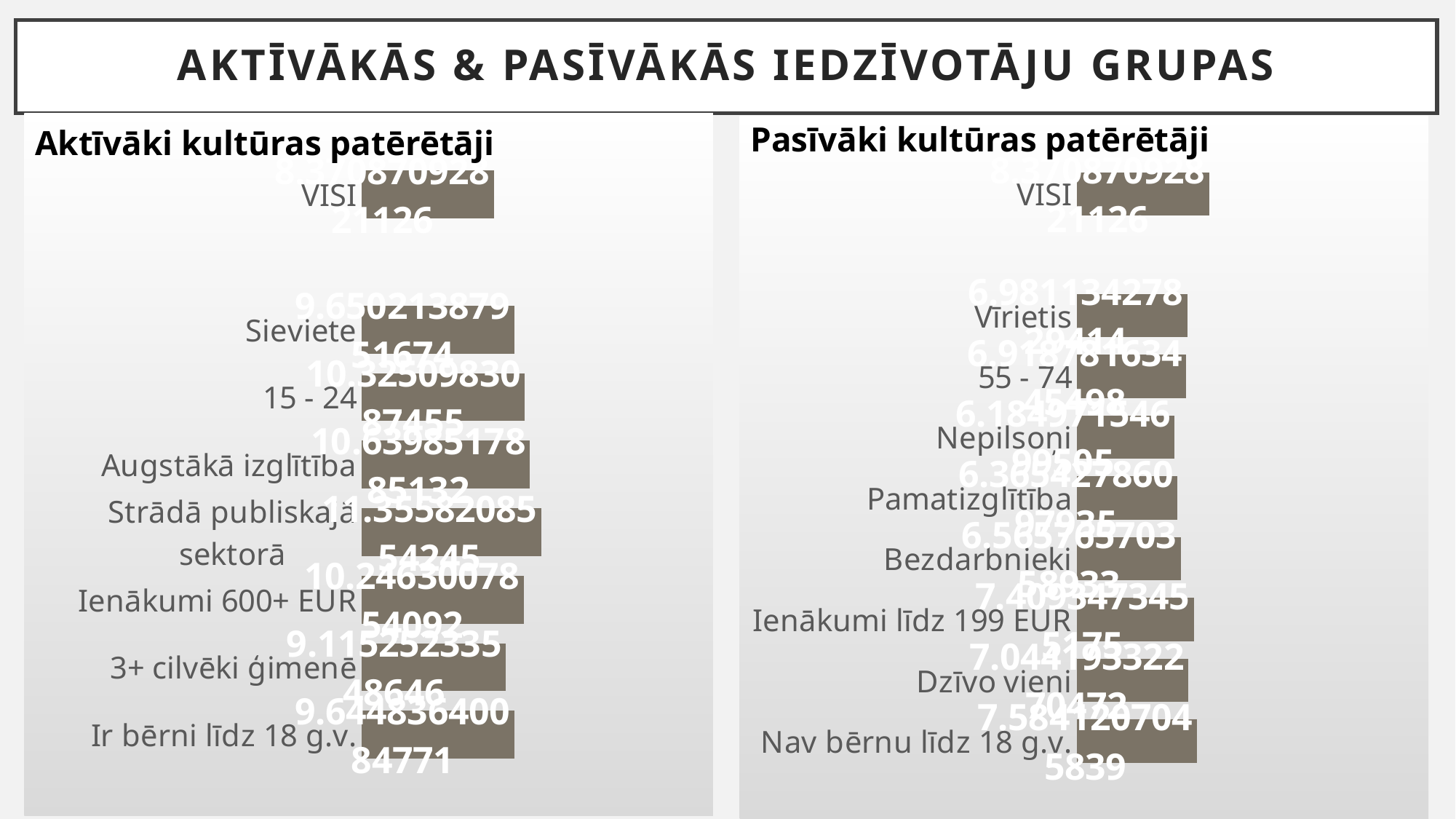
How many categories are shown in the "Aktīvāki kultūras patērētāji" chart on the left? 8 In the "Aktīvāki kultūras patērētāji" chart on the left, which category has the longest bar? Strādā publiskajā sektorā What kind of chart is the "Pasīvāki kultūras patērētāji" chart on the right? bar chart In the "Pasīvāki kultūras patērētāji" chart on the right, which has the larger value: VISI or Nepilsoņi? VISI What is the title of the chart on the right side of the slide? Pasīvāki kultūras patērētāji In the "Aktīvāki kultūras patērētāji" chart on the left, which has the larger value: Sieviete or Augstākā izglītība? Augstākā izglītība In the "Pasīvāki kultūras patērētāji" chart on the right, which category has the longest bar? VISI In the "Aktīvāki kultūras patērētāji" chart on the left, which category has the shortest bar? VISI In the "Pasīvāki kultūras patērētāji" chart on the right, which has the larger value: Pamatizglītība or Nav bērnu līdz 18 g.v.? Nav bērnu līdz 18 g.v. What kind of chart is the "Aktīvāki kultūras patērētāji" chart on the left? bar chart How many categories are shown in the "Pasīvāki kultūras patērētāji" chart on the right? 9